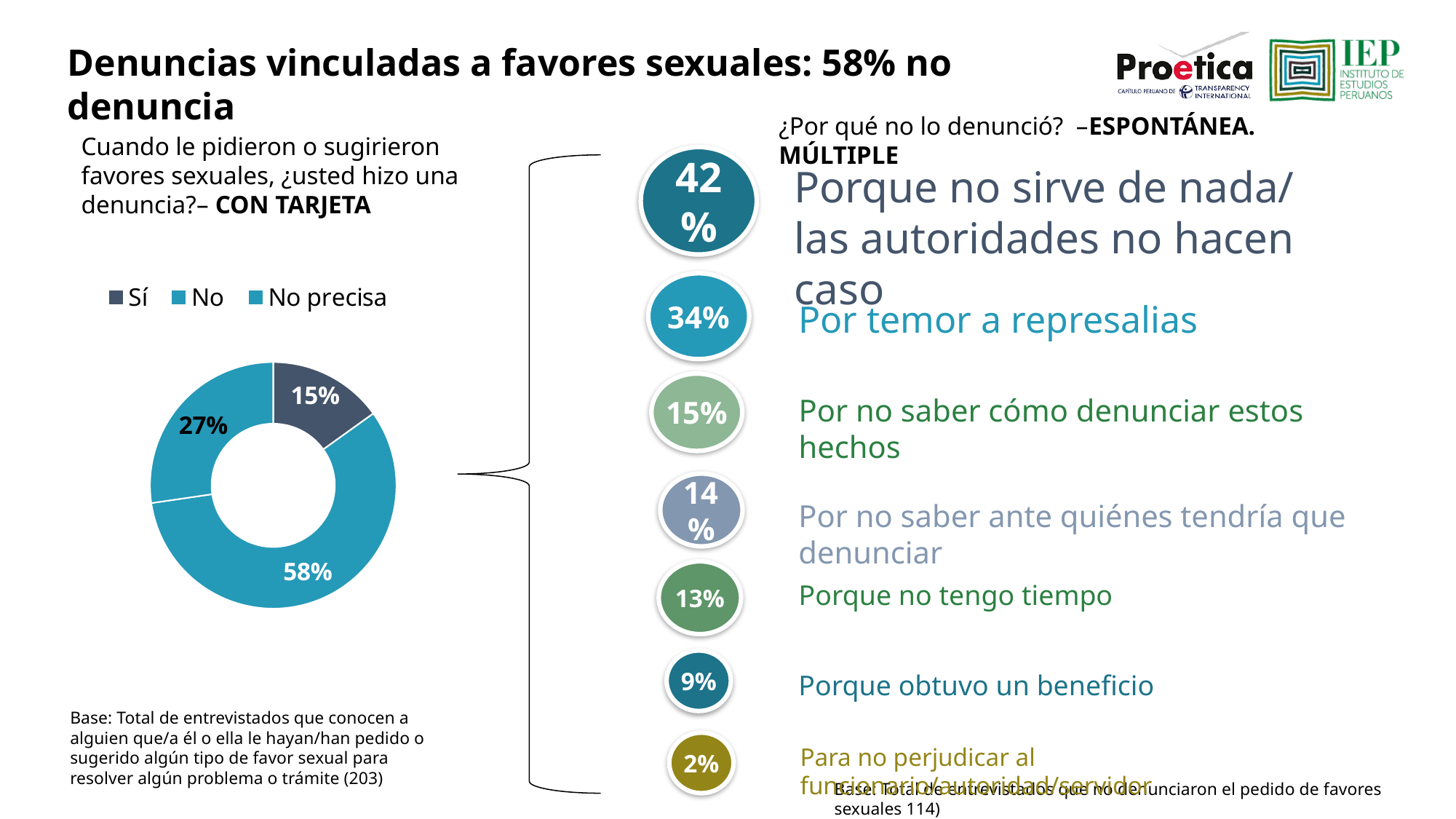
In the donut chart, what percentage corresponds to 'No precisa'? 27% What type of chart is shown on the left of the slide? Pie (donut) chart Which category has the smallest share in the donut chart? Sí In the donut chart, what percentage corresponds to 'No'? 58% In the list of reasons on the right, what percentage is shown for 'Por temor a represalias'? 34% In the donut chart, what is the difference between the 'No' share and the 'Sí' share? 43 percentage points How many slices does the donut chart have? 3 Which category has the largest share in the donut chart? No In the list of reasons on the right, which reason has the highest percentage? Porque no sirve de nada/ las autoridades no hacen caso In the donut chart, which is larger: 'No precisa' or 'Sí'? No precisa In the donut chart, what percentage corresponds to 'Sí'? 15% How many categories does the legend of the donut chart list? 3